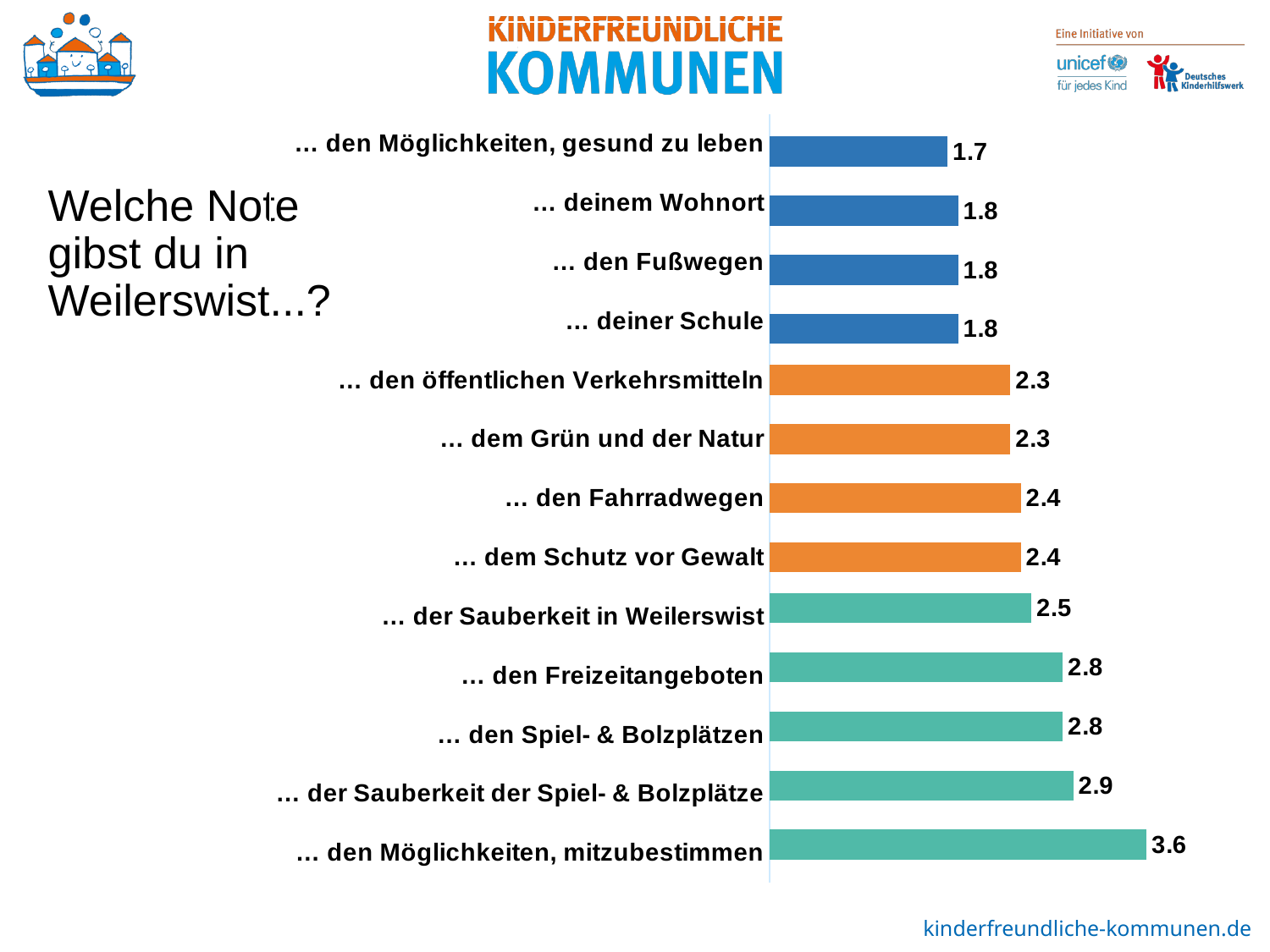
What value is shown for "… den Fahrradwegen"? 2.4 What colour are the bars for the four categories with the lowest values? blue Which category has the highest value? … den Möglichkeiten, mitzubestimmen What type of chart is shown on the slide? bar chart What value is shown for "… der Sauberkeit in Weilerswist"? 2.5 What value is shown for "… den Möglichkeiten, mitzubestimmen"? 3.6 Which has a larger value, "… den Freizeitangeboten" or "… dem Grün und der Natur"? … den Freizeitangeboten What is the difference between the values for "… der Sauberkeit der Spiel- & Bolzplätze" and "… deiner Schule"? 1.1 What is the difference between the values for "… den Möglichkeiten, mitzubestimmen" and "… den Möglichkeiten, gesund zu leben"? 1.9 Do the values increase or decrease from the top bar to the bottom bar? increase Which category has the lowest value? … den Möglichkeiten, gesund zu leben How many categories are shown in the chart? 13